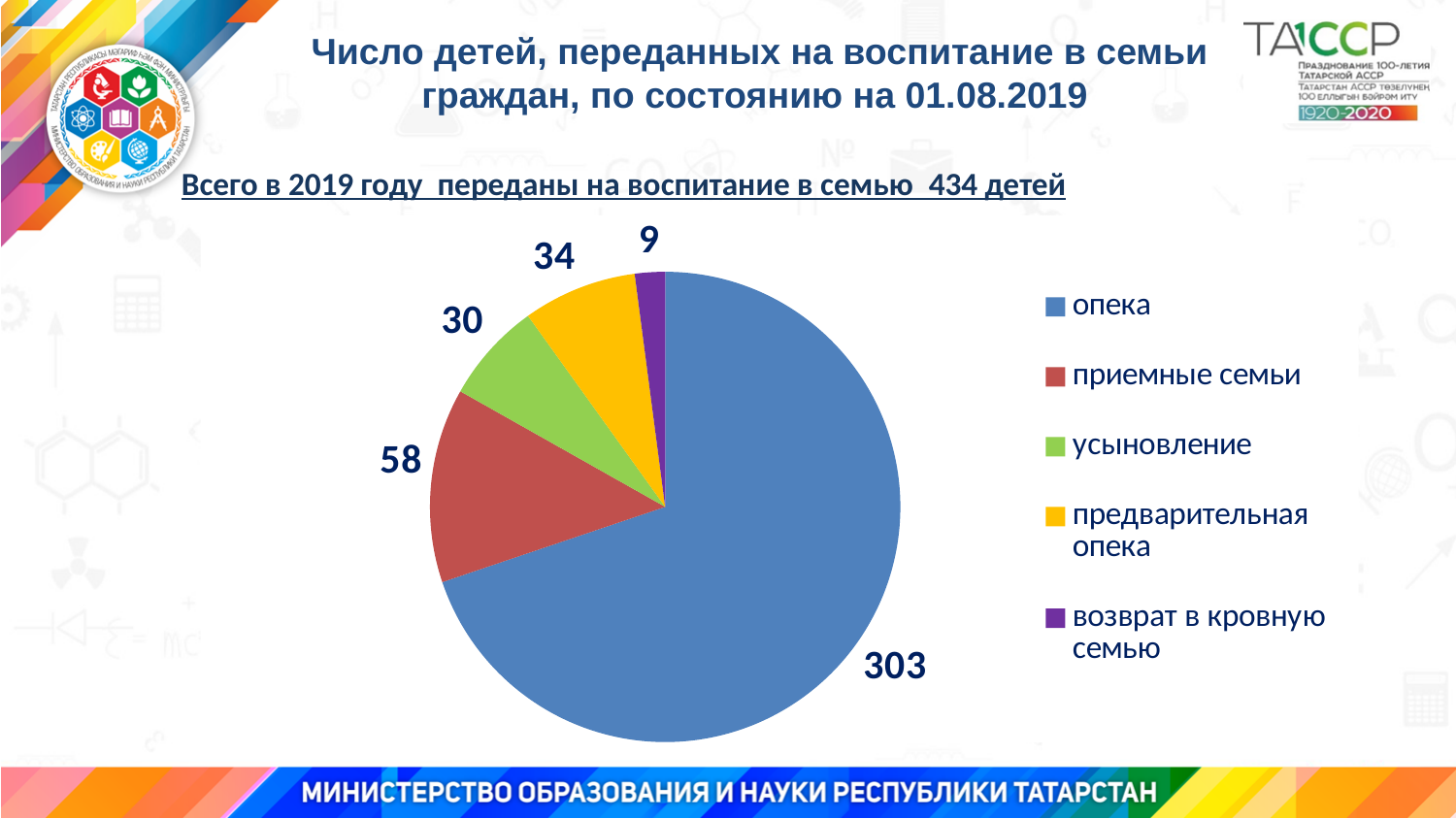
What is the difference between the values for 'опека' and 'приемные семьи'? 245 What is the value for 'приемные семьи' in the pie chart? 58 Which category has the largest slice of the pie chart? опека What is the value for 'возврат в кровную семью' in the pie chart? 9 How many children are in the 'опека' slice of the pie chart? 303 How many categories does the pie chart legend list? 5 Which category has the smallest slice of the pie chart? возврат в кровную семью What is the value for 'предварительная опека' in the pie chart? 34 What is the value for 'усыновление' in the pie chart? 30 Which is larger: 'предварительная опека' or 'усыновление'? предварительная опека What is the total number of children across all slices of the pie chart? 434 What type of chart is shown on the slide? pie chart